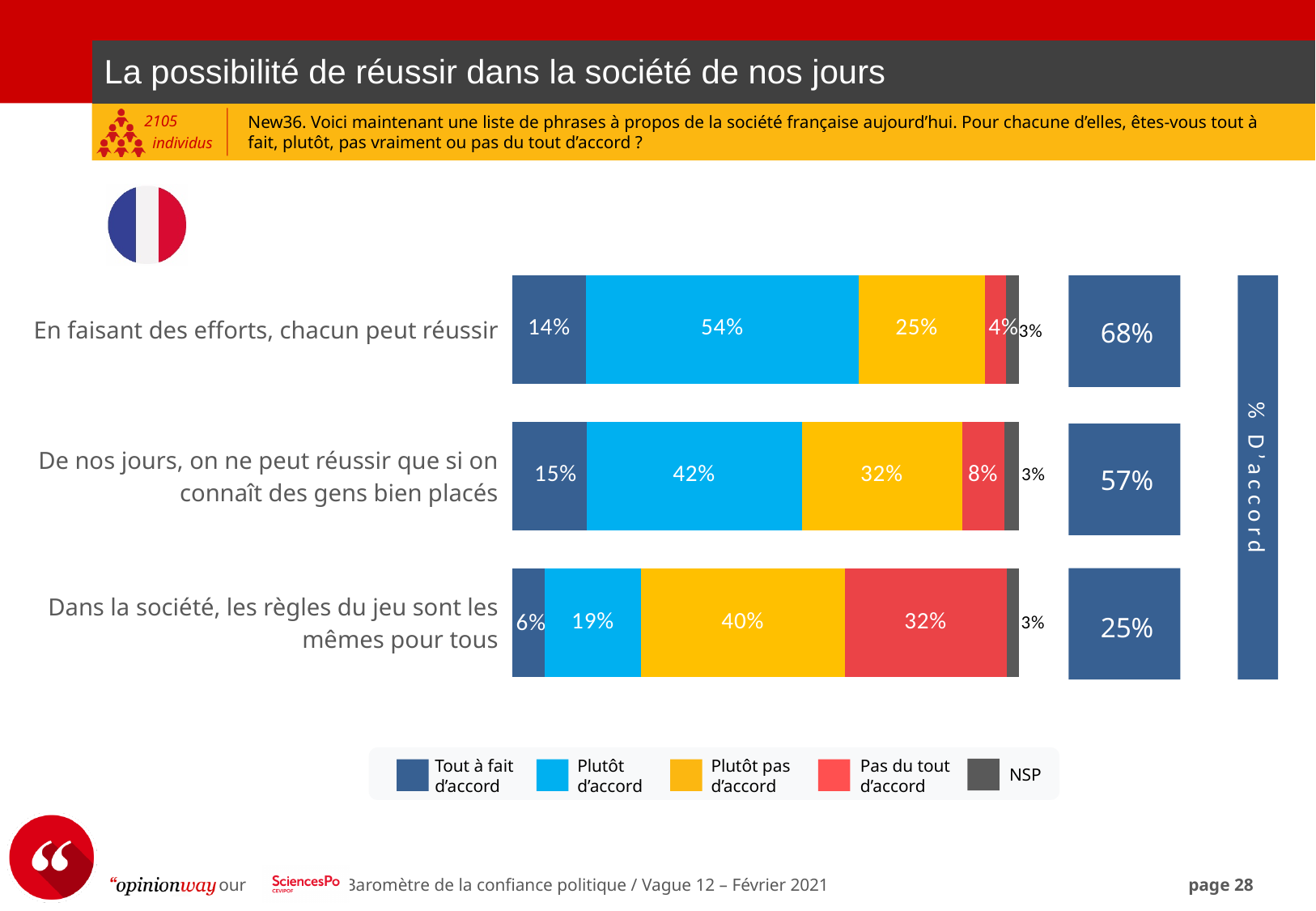
What percentage answered "Pas du tout d'accord" to "Dans la société, les règles du jeu sont les mêmes pour tous"? 32% What is the combined share of "Tout à fait d'accord" and "Plutôt d'accord" for "En faisant des efforts, chacun peut réussir"? 68% What is the "% D'accord" value for "De nos jours, on ne peut réussir que si on connaît des gens bien placés"? 57% How many statements are shown in the chart? 3 How many percentage points higher is the "Plutôt pas d'accord" share for "Dans la société, les règles du jeu sont les mêmes pour tous" than for "En faisant des efforts, chacun peut réussir"? 15 percentage points What percentage answered "Plutôt d'accord" to "En faisant des efforts, chacun peut réussir"? 54% For "De nos jours, on ne peut réussir que si on connaît des gens bien placés", which is larger: the "Plutôt d'accord" share or the "Plutôt pas d'accord" share? Plutôt d'accord What kind of chart is shown on the slide? Stacked bar chart Which statement has the highest "% D'accord" value? En faisant des efforts, chacun peut réussir How many response categories does the legend list? 5 Which statement has the lowest "Tout à fait d'accord" share? Dans la société, les règles du jeu sont les mêmes pour tous What is the NSP share for "De nos jours, on ne peut réussir que si on connaît des gens bien placés"? 3%